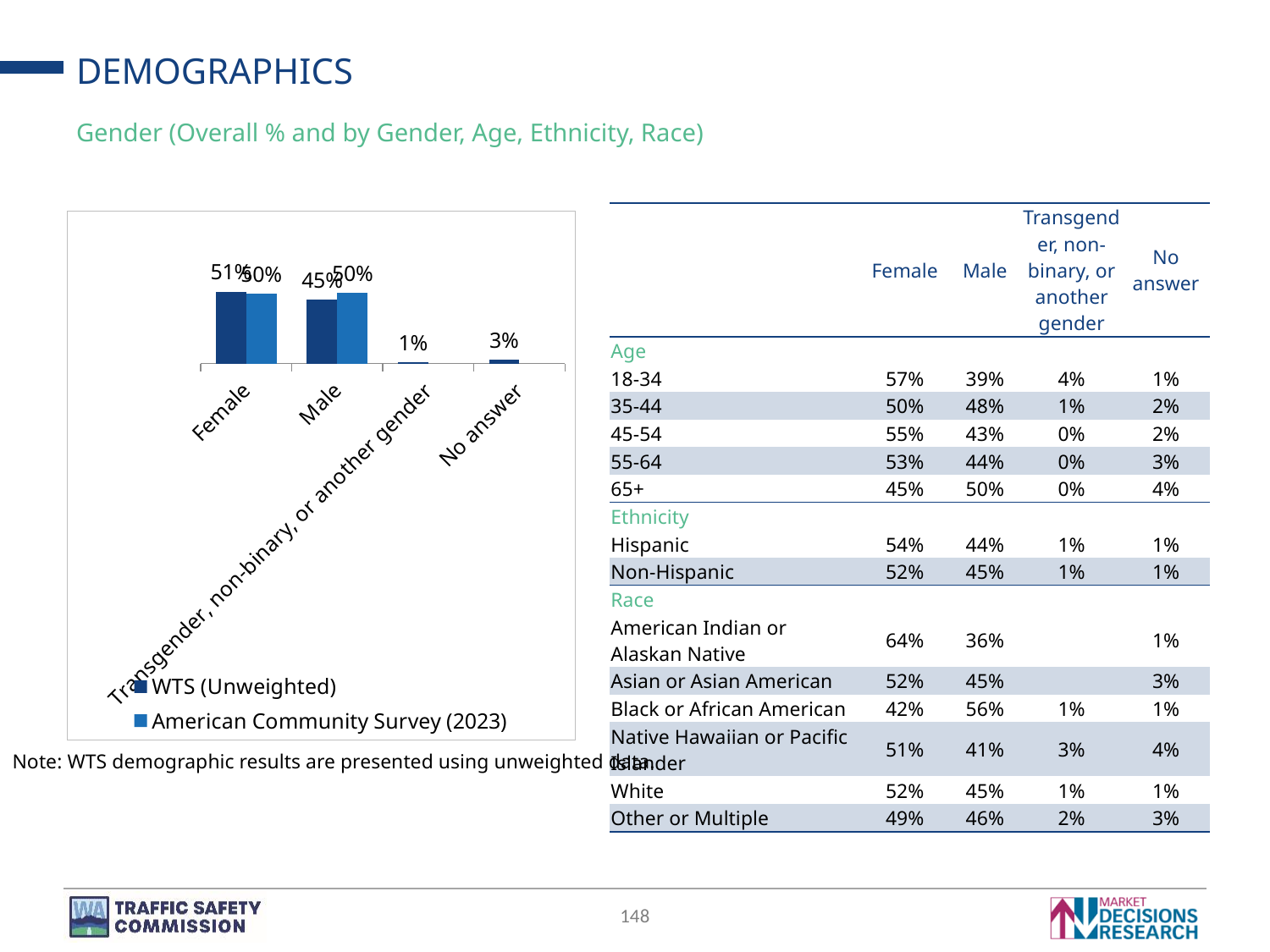
What kind of chart is shown on the left of the slide? bar chart What is the WTS (Unweighted) value for No answer in the chart? 3% Which category has the highest WTS (Unweighted) value in the chart? Female What is the American Community Survey (2023) value for Male in the chart? 50% What is the WTS (Unweighted) value for Male in the chart? 45% What is the WTS (Unweighted) value for Female in the chart? 51% What is the WTS (Unweighted) value for Transgender, non-binary, or another gender in the chart? 1% What is the difference between the WTS (Unweighted) values for Female and Male in the chart? 6% How many categories are shown on the x axis of the chart? 4 How many series does the chart legend list? 2 For Male, which series has the larger value in the chart: WTS (Unweighted) or American Community Survey (2023)? American Community Survey (2023) Which category has the lowest WTS (Unweighted) value in the chart? Transgender, non-binary, or another gender